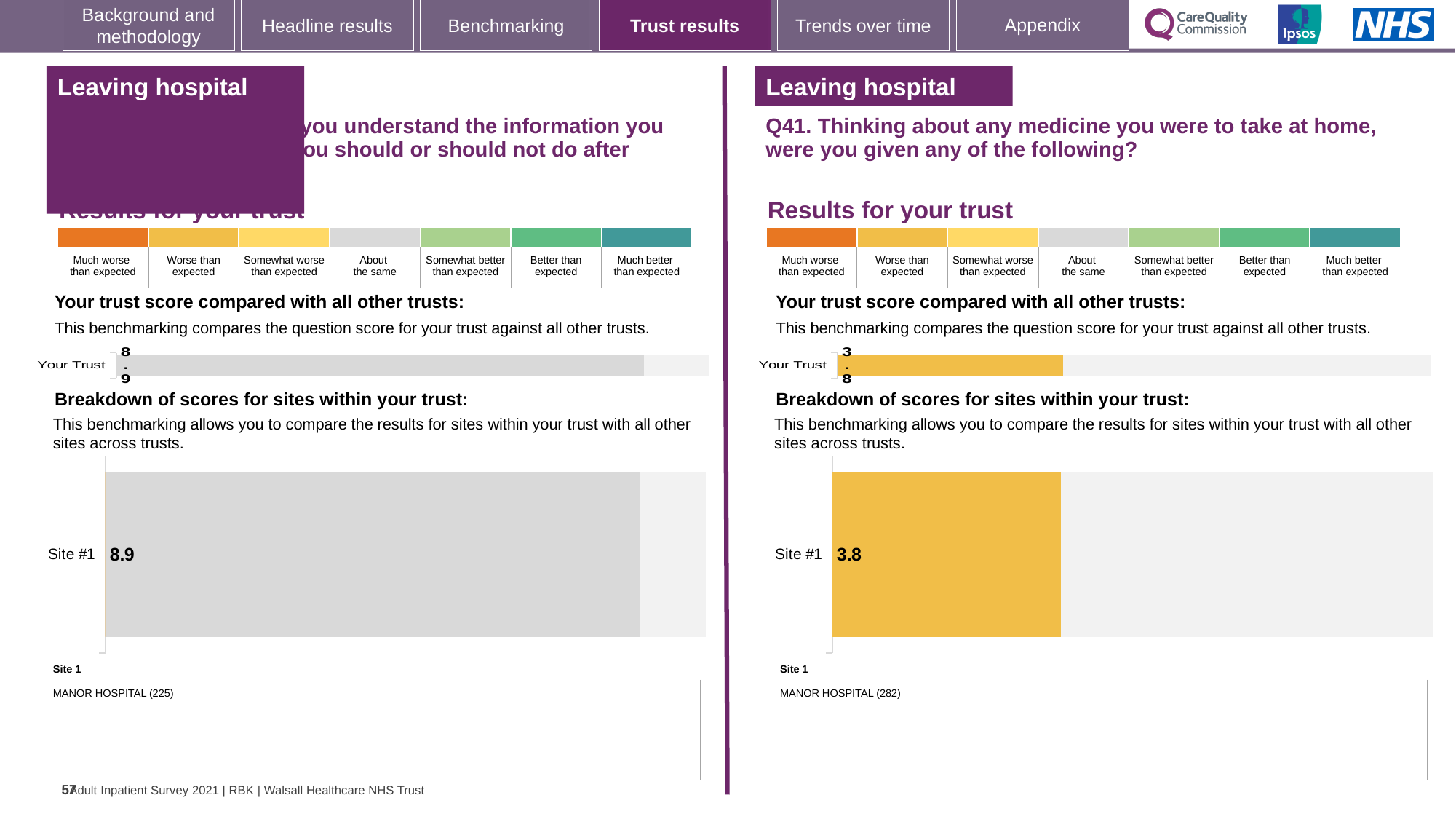
On the right-hand chart for Q41, is the Your Trust score greater or less than the Site #1 score, or are they equal? Equal What is the difference between the Site #1 score on the left-hand chart and the Site #1 score on the right-hand chart for Q41? 5.1 On the right-hand panel for Q41, which site is listed as Site 1? MANOR HOSPITAL (282) On the left-hand chart, what is the score shown for Site #1? 8.9 On the left-hand chart, what is the score shown for Your Trust? 8.9 On the right-hand chart for Q41, what is the score shown for Site #1? 3.8 On the right-hand chart for Q41, what is the score shown for Your Trust? 3.8 How many sites are shown in the site breakdown chart on the right-hand panel for Q41? 1 What kind of chart is used to show the Site #1 score on the right-hand panel for Q41? Bar chart Which is larger: the Site #1 score on the left-hand chart or the Site #1 score on the right-hand chart for Q41? Left-hand chart (8.9) On the left-hand panel, which site is listed as Site 1? MANOR HOSPITAL (225)